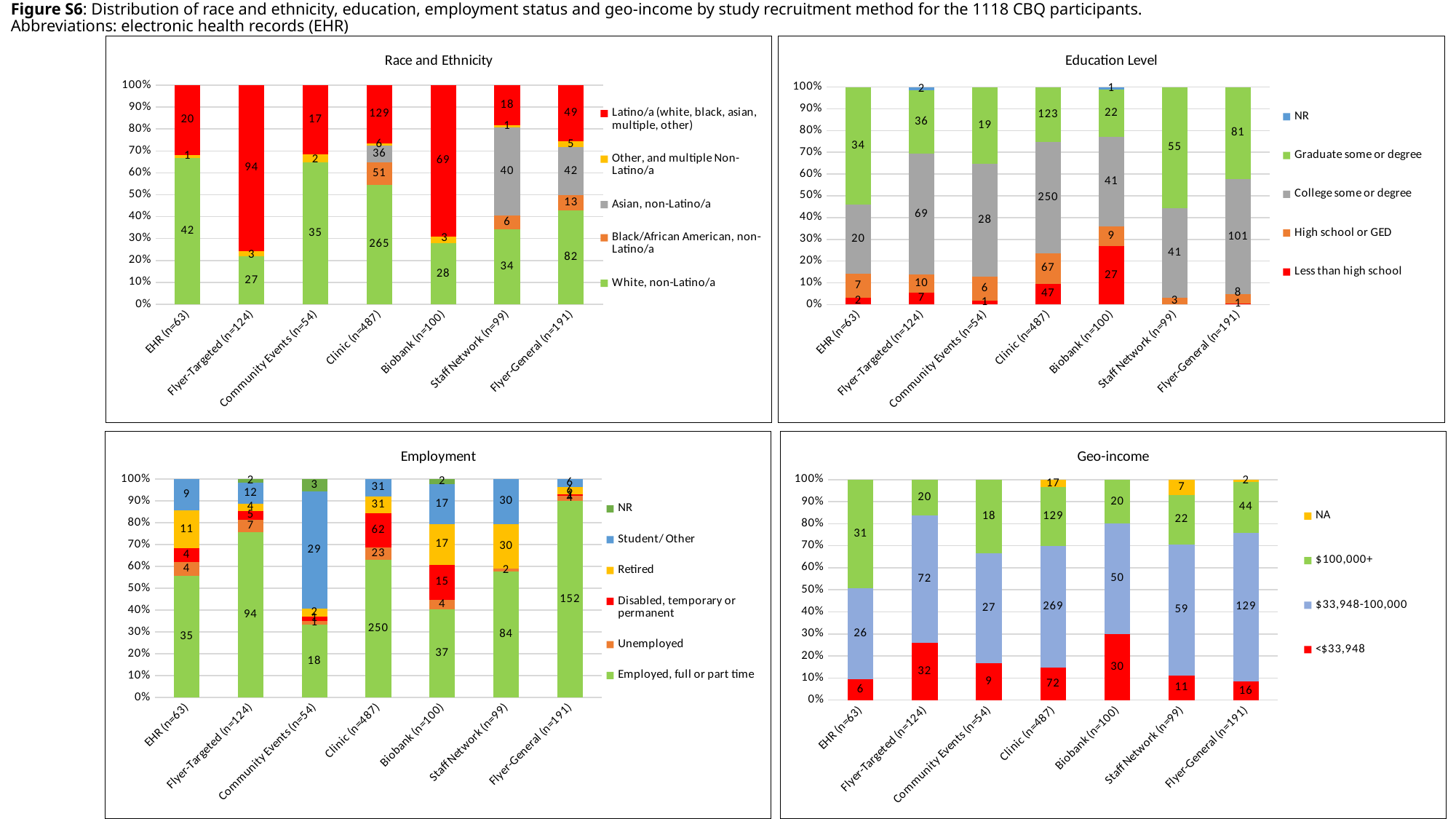
In the Race and Ethnicity chart, what is the Latino/a count for Flyer-Targeted (n=124)? 94 In the Race and Ethnicity chart, how many White, non-Latino/a participants are in the Clinic (n=487) bar? 265 In the Geo-income chart, what is the $33,948-100,000 count for Clinic (n=487)? 269 In the Education Level chart, which recruitment method has the largest Less than high school count? Clinic (n=487) How many recruitment method categories are shown on the x axis of the Geo-income chart? 7 In the Geo-income chart, is the $100,000+ share for EHR (n=63) greater or less than 40%? greater In the Education Level chart, what is the difference between the Graduate some or degree counts for Staff Network (n=99) and EHR (n=63)? 21 In the Employment chart, how many Community Events (n=54) participants are Student/Other? 29 In the Geo-income chart, which recruitment method has the highest <$33,948 count? Clinic (n=487) In the Education Level chart, how many Clinic (n=487) participants have College some or degree? 250 In the Race and Ethnicity chart, how many series does the legend list? 5 In the Employment chart, how many series does the legend list? 6